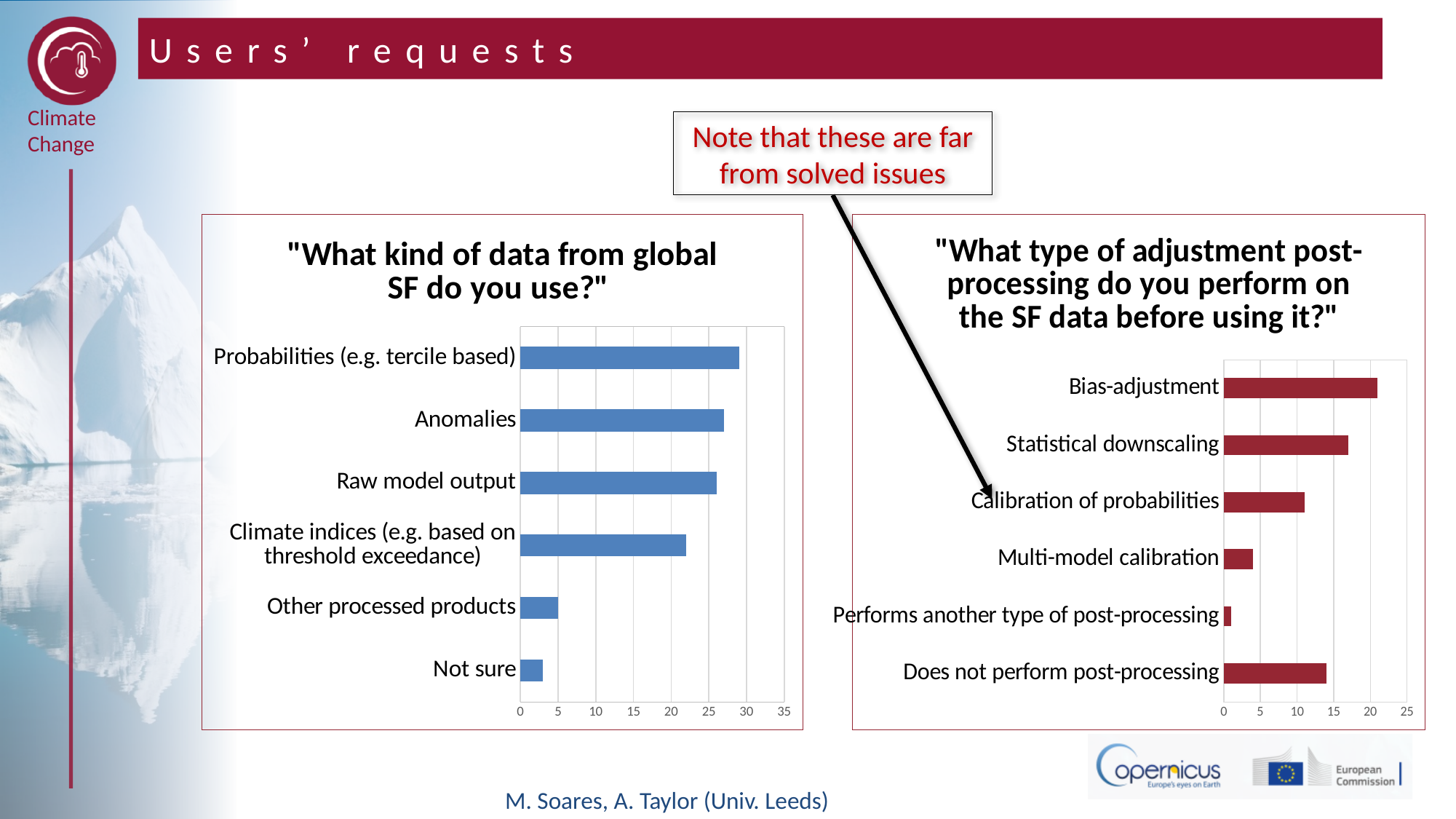
In the chart "What kind of data from global SF do you use?", which is larger: Anomalies or Climate indices (e.g. based on threshold exceedance)? Anomalies In the chart "What kind of data from global SF do you use?", is the value for Other processed products greater or less than 10? less In the chart "What kind of data from global SF do you use?", which category has the lowest value? Not sure How many categories does the chart "What type of adjustment post-processing do you perform on the SF data before using it?" show? 6 In the chart "What kind of data from global SF do you use?", which category has the highest value? Probabilities (e.g. tercile based) In the chart "What type of adjustment post-processing do you perform on the SF data before using it?", which is larger: Statistical downscaling or Does not perform post-processing? Statistical downscaling In the chart "What type of adjustment post-processing do you perform on the SF data before using it?", which category has the lowest value? Performs another type of post-processing What kind of chart is "What kind of data from global SF do you use?"? bar chart In the chart "What kind of data from global SF do you use?", is the value for Climate indices (e.g. based on threshold exceedance) greater or less than 20? greater In the chart "What type of adjustment post-processing do you perform on the SF data before using it?", which category has the highest value? Bias-adjustment How many categories does the chart "What kind of data from global SF do you use?" show? 6